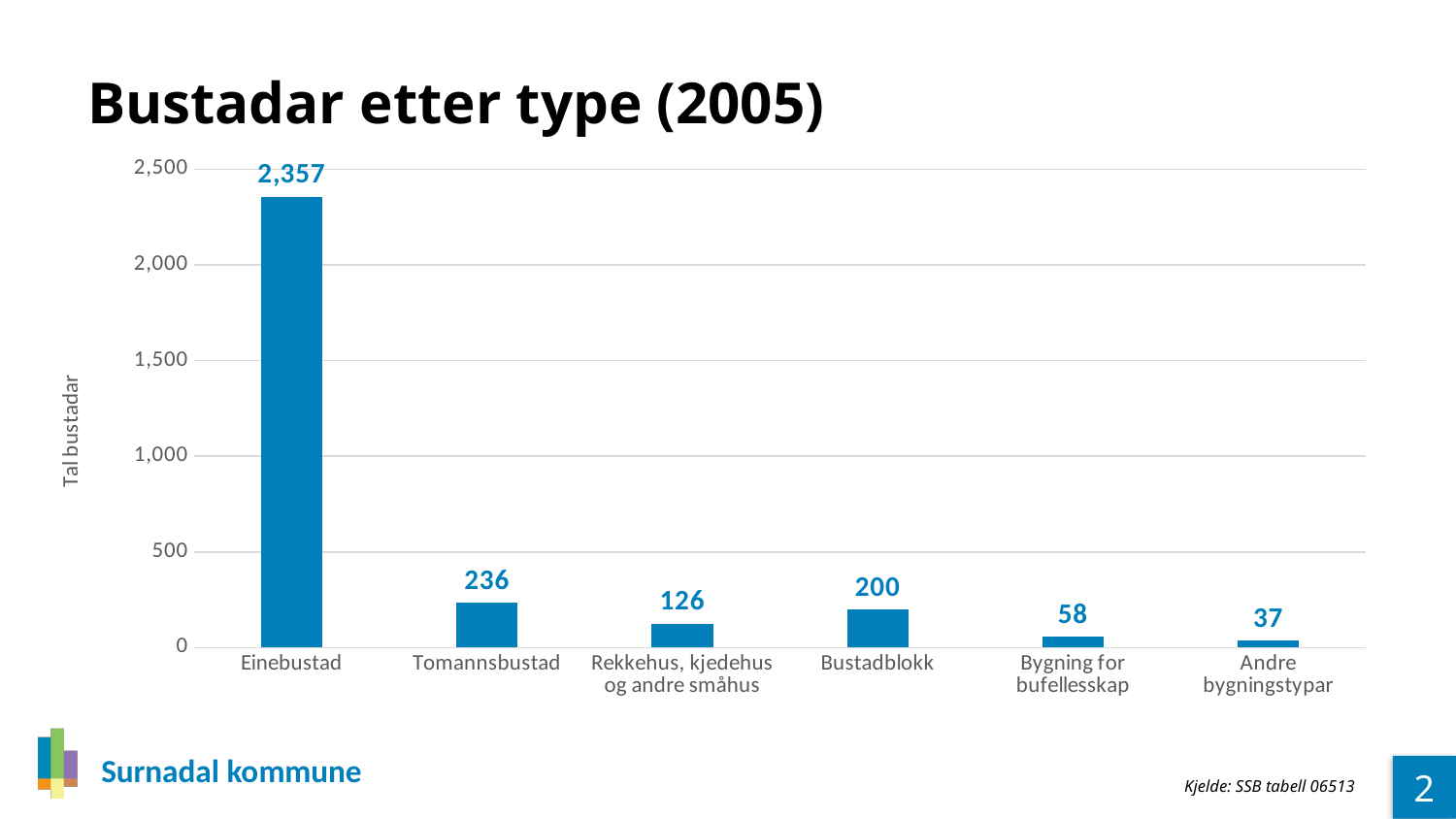
What kind of chart is shown on the slide? bar chart How many categories are shown on the x axis? 6 Which category has the highest value? Einebustad Is the value for Einebustad greater or less than 2,000? greater What is the value for Einebustad? 2,357 What is the value for Tomannsbustad? 236 What is the value for Andre bygningstypar? 37 What is the difference between the values for Tomannsbustad and Bustadblokk? 36 Which is larger, the value for Rekkehus, kjedehus og andre småhus or the value for Bygning for bufellesskap? Rekkehus, kjedehus og andre småhus Which category has the lowest value? Andre bygningstypar What is the value for Bustadblokk? 200 What is the label of the vertical axis? Tal bustadar